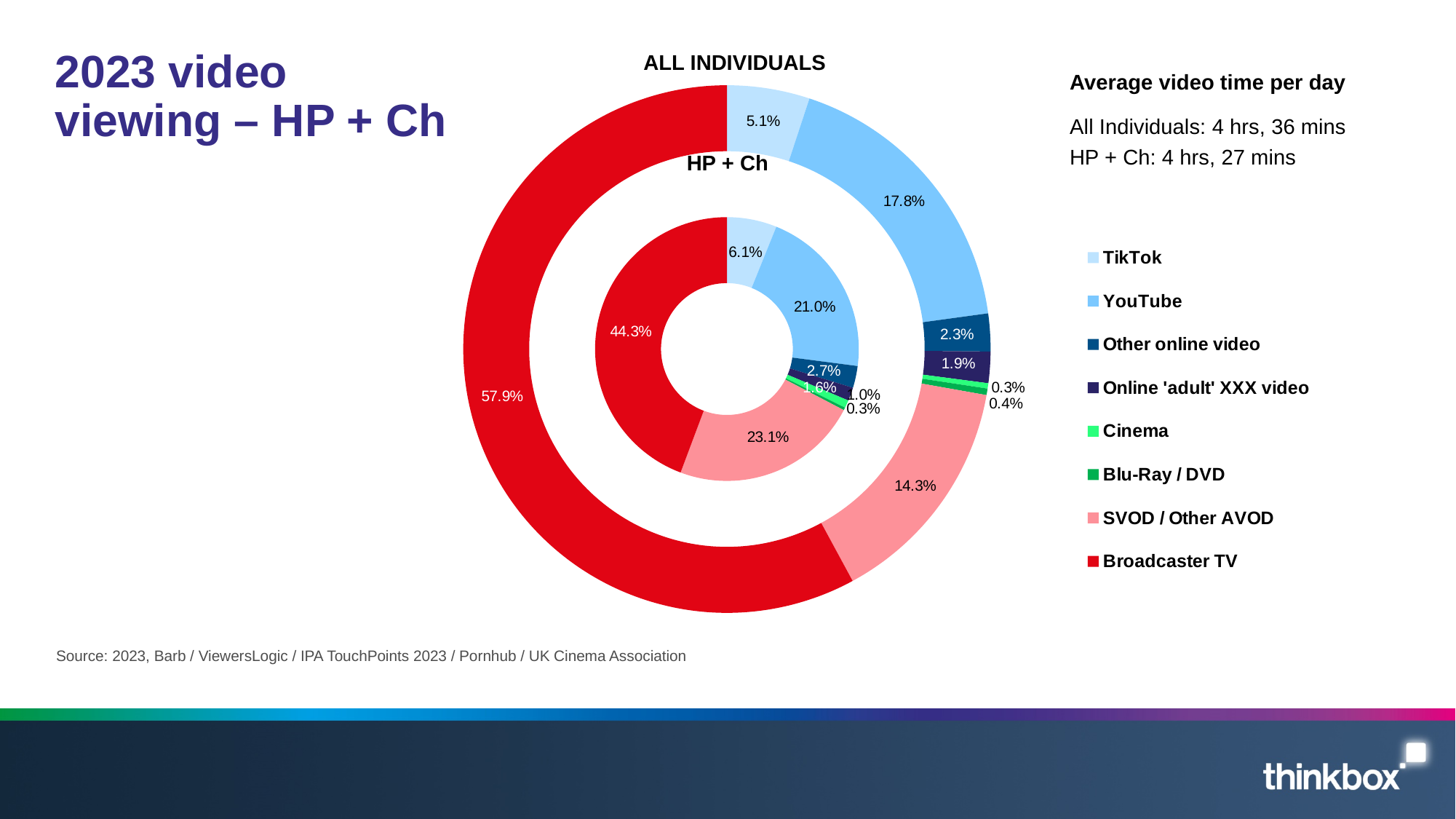
What kind of chart is shown on the slide? Doughnut chart In the HP + Ch ring, what share does Broadcaster TV have? 44.3% In the HP + Ch ring, what share does TikTok have? 6.1% Which is larger: the YouTube share for HP + Ch or for ALL INDIVIDUALS? HP + Ch What is the difference between the Broadcaster TV share for ALL INDIVIDUALS and for HP + Ch? 13.6% In the ALL INDIVIDUALS ring, what share does YouTube have? 17.8% Which category has the largest share in the ALL INDIVIDUALS ring? Broadcaster TV According to the text on the slide, what is the average video time per day for HP + Ch? 4 hrs, 27 mins Which category has the smallest share in the ALL INDIVIDUALS ring? Cinema In the HP + Ch ring, what share does SVOD / Other AVOD have? 23.1% How many categories does the legend list? 8 In the ALL INDIVIDUALS ring, what share does Broadcaster TV have? 57.9%